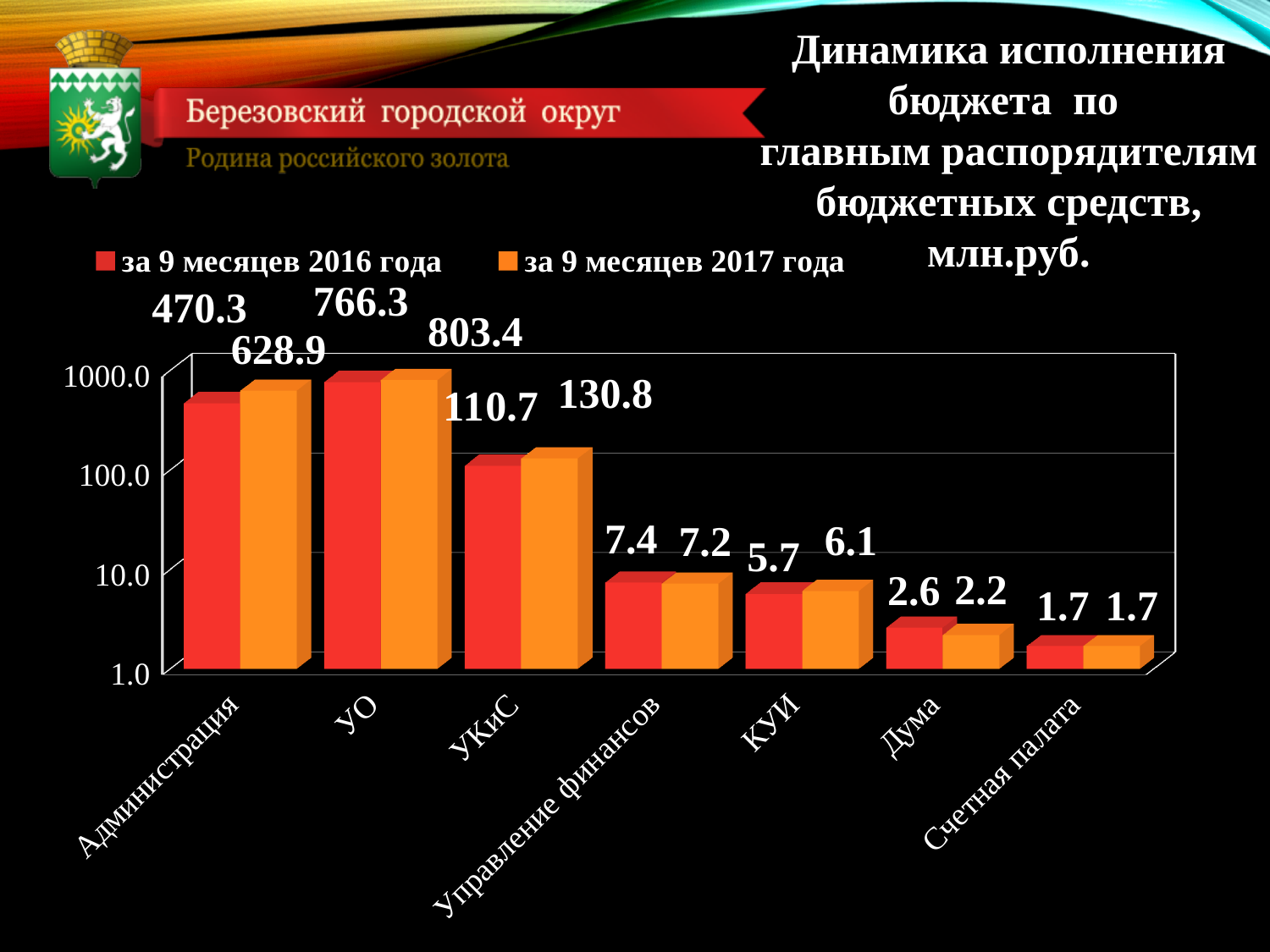
What is the difference between the 2017 and 2016 values for Администрация? 158.6 What is the value for КУИ for за 9 месяцев 2017 года? 6.1 What is the value for Администрация for за 9 месяцев 2016 года? 470.3 What colour are the bars for за 9 месяцев 2017 года? Orange What kind of chart is shown on the slide? Bar chart How many categories are shown on the x axis? 7 How many series does the legend list? 2 What is the difference between the 2017 and 2016 values for УКиС? 20.1 For Дума, which is larger: the value for за 9 месяцев 2016 года or за 9 месяцев 2017 года? за 9 месяцев 2016 года What is the value for УО for за 9 месяцев 2017 года? 803.4 Which category has the highest value for за 9 месяцев 2016 года? УО Which category has the lowest value for за 9 месяцев 2017 года? Счетная палата